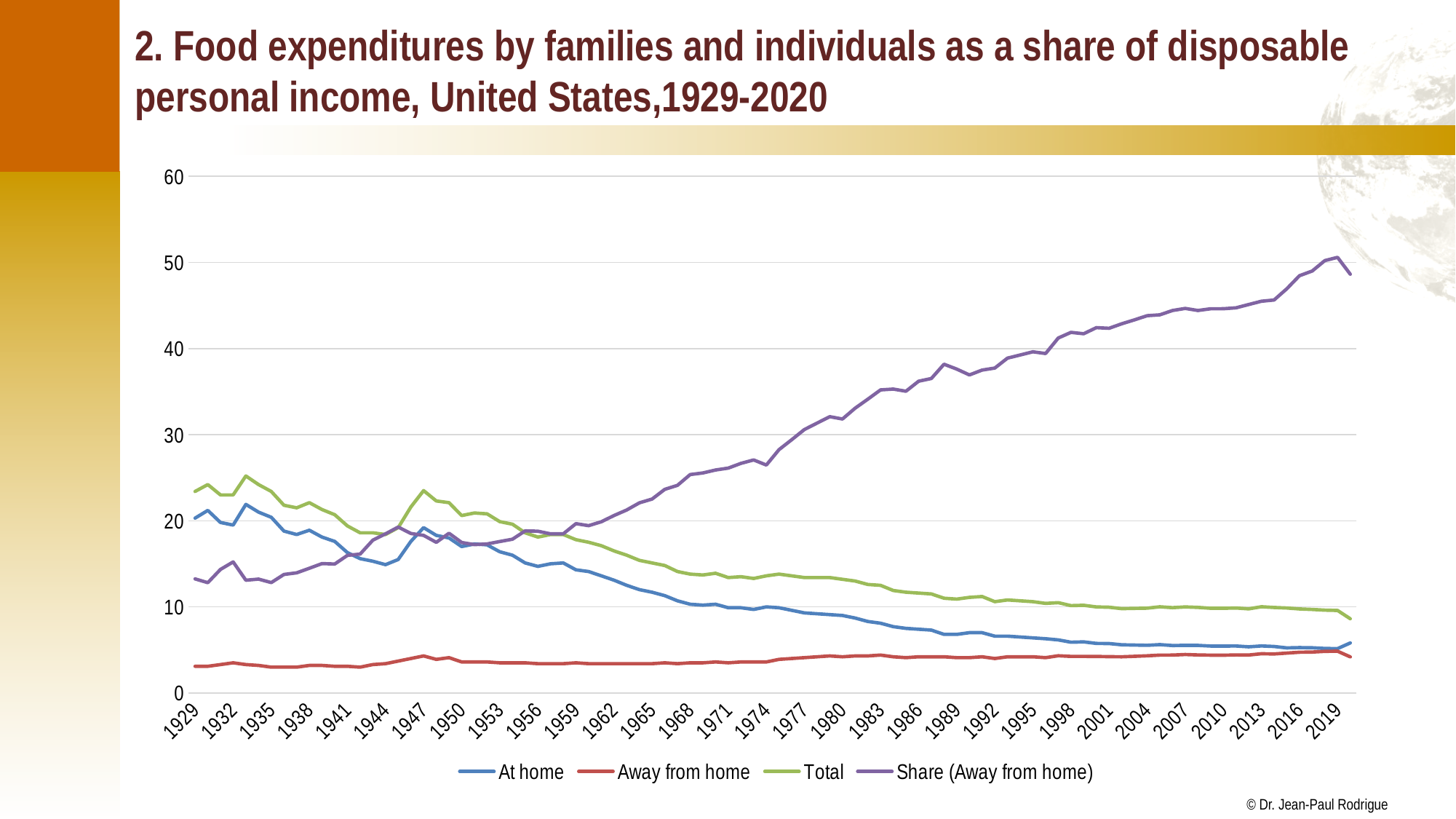
Is the value for Share (Away from home) in 2019 greater or less than 40? greater Does the Total line generally rise or fall from 1929 to 2020? Fall Which series has the highest value at the right end of the chart (2020)? Share (Away from home) Is the value for At home in 2019 greater or less than 10? less What period does the chart title say the data covers? 1929-2020 Does the At home line generally rise or fall across the chart? Fall Is the value for Total in 1929 greater or less than 20? greater What kind of chart is shown on the slide? Line chart How many series does the legend list? 4 Does the Share (Away from home) line generally rise or fall from 1929 to 2020? Rise In 1929, which is larger, the At home value or the Away from home value? At home What are the four series named in the legend? At home, Away from home, Total, Share (Away from home)